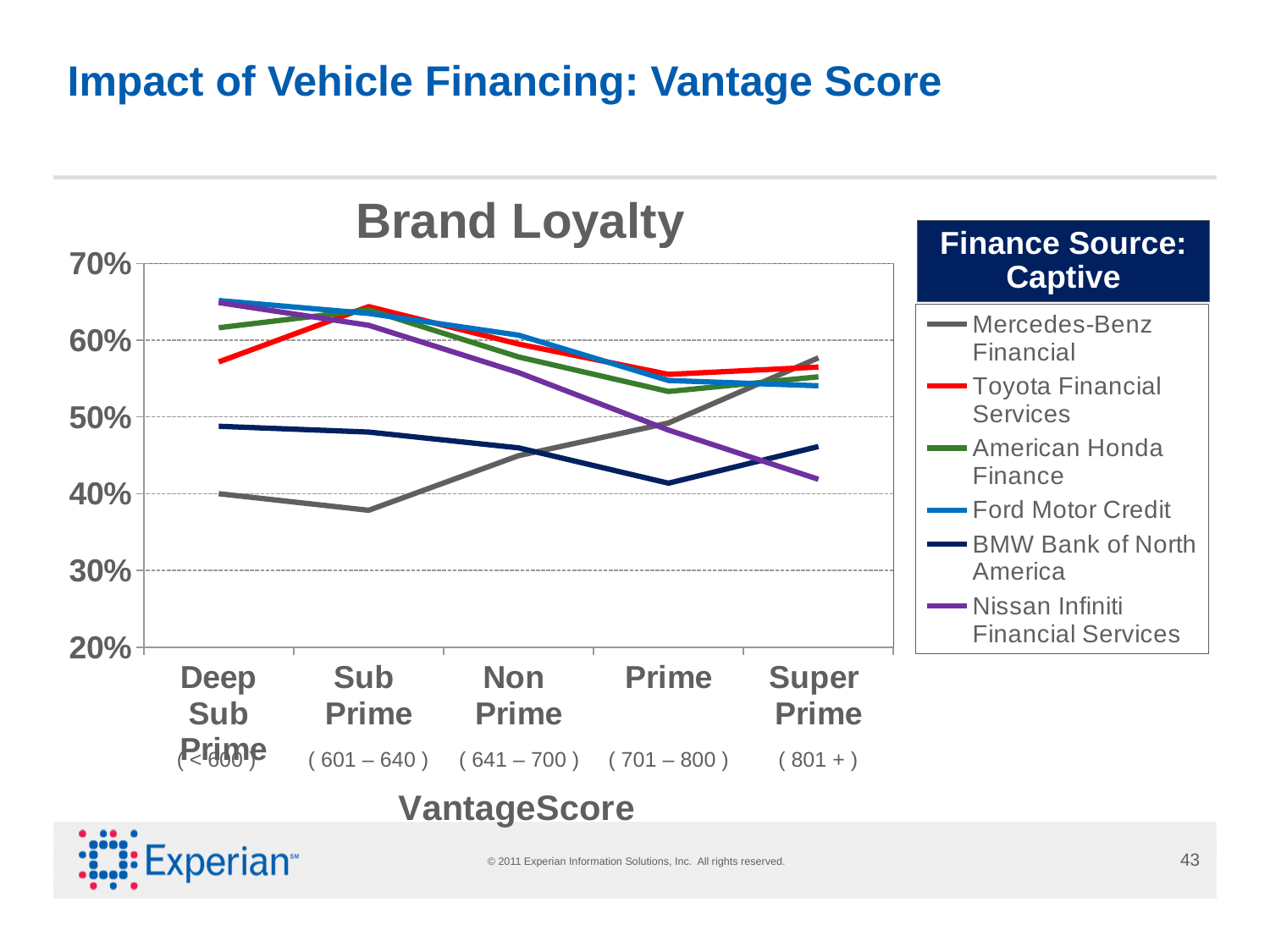
Is the brand loyalty value for BMW Bank of North America in the Prime category greater or less than 50%? less What is the title shown above the legend of the Brand Loyalty chart? Finance Source: Captive Does the brand loyalty line for Mercedes-Benz Financial rise or fall from Sub Prime to Super Prime? rise Is the brand loyalty value for Nissan Infiniti Financial Services in the Super Prime category greater or less than 50%? less How many finance sources does the legend of the Brand Loyalty chart list? 6 Does the brand loyalty line for Nissan Infiniti Financial Services rise or fall from Deep Sub Prime to Super Prime? fall Which finance source has the lowest brand loyalty in the Deep Sub Prime category? Mercedes-Benz Financial Is the brand loyalty value for Toyota Financial Services in the Sub Prime category greater or less than 60%? greater How many VantageScore categories are shown along the x axis of the Brand Loyalty chart? 5 In the Super Prime category, which has higher brand loyalty: Mercedes-Benz Financial or BMW Bank of North America? Mercedes-Benz Financial What kind of chart is the Brand Loyalty chart? line chart